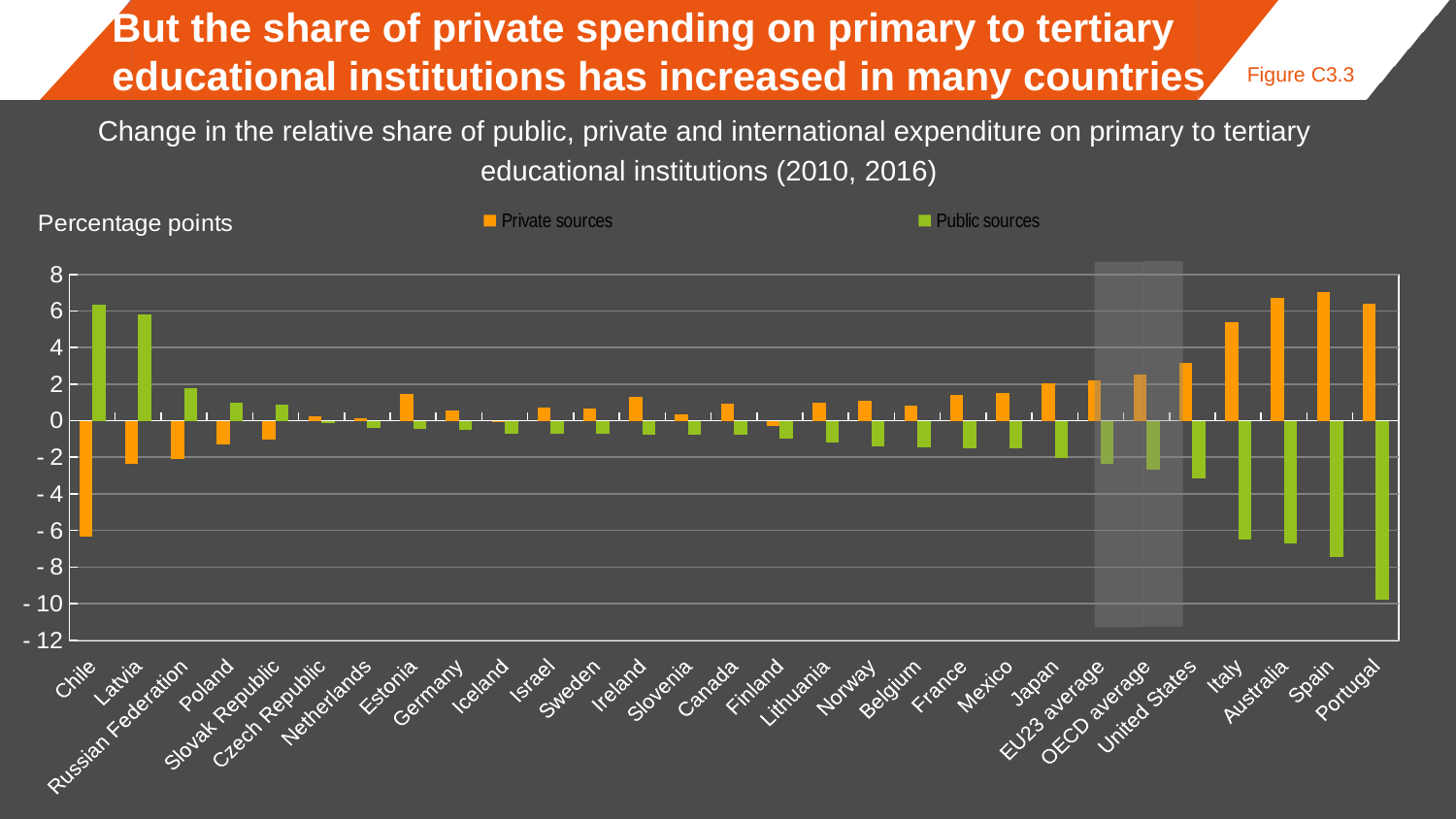
How many series does the legend list? 2 What kind of chart is shown on the slide? bar chart Do the Private sources values generally rise or fall moving from left to right along the x axis? rise Which category has the lowest value for Private sources? Chile Is the value for Public sources in Portugal greater or less than -8? less Which colour represents Public sources in the chart? green Which category has the lowest value for Public sources? Portugal Is the value for Public sources in Latvia greater or less than 4? greater Which is larger, the Private sources value for Italy or for Spain? Spain Is the value for Private sources in Spain greater or less than 6? greater How many countries or averages are shown along the x axis? 29